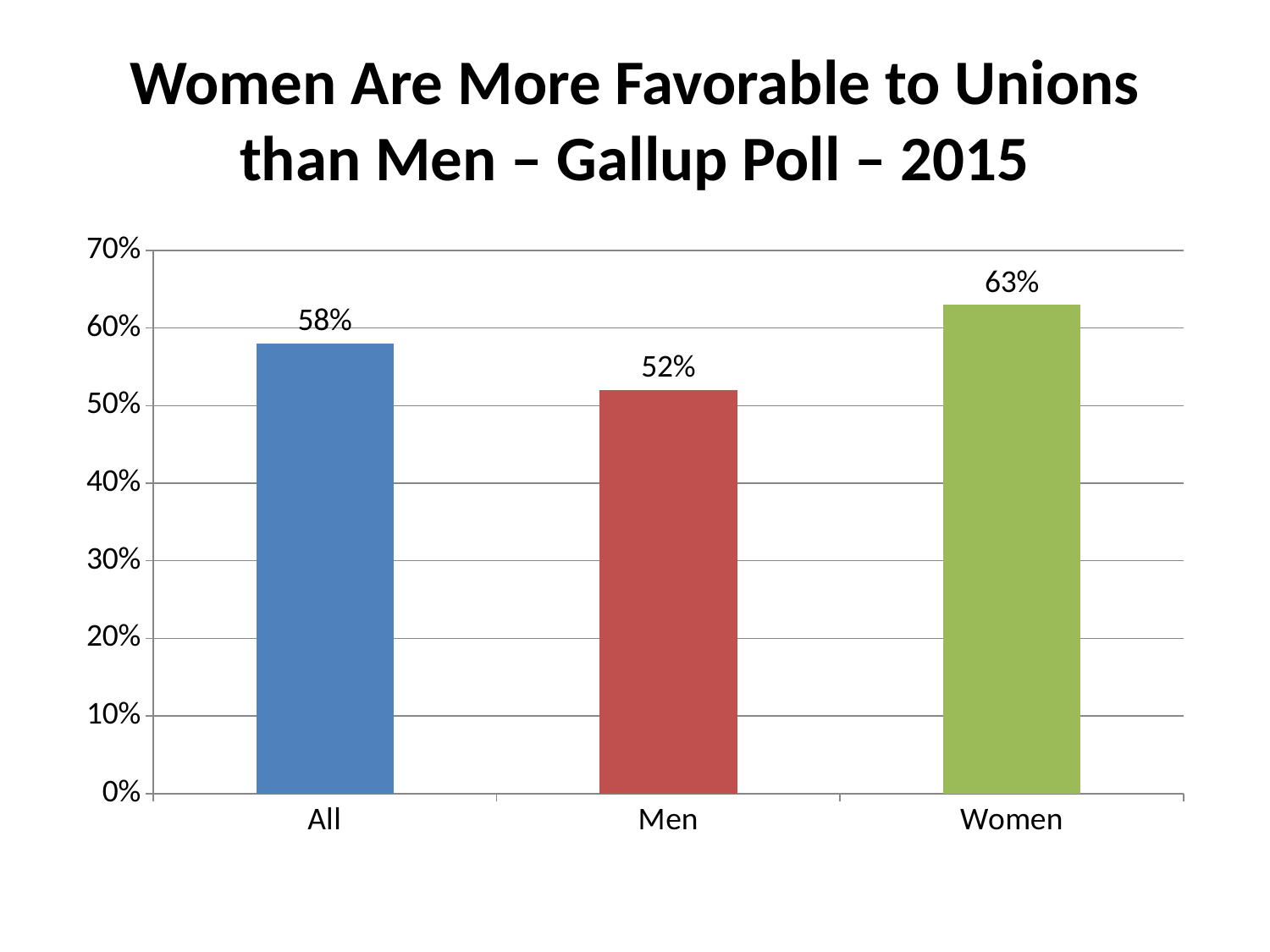
Is the value for Women greater or less than 60%? greater Which category has the highest value? Women What colour is the bar for Women? green Which is larger, the value for All or the value for Men? All What is the value for Men? 52% What is the difference between the values for All and Men? 6% What is the value for All? 58% What is the difference between the values for Women and Men? 11% What is the value for Women? 63% What kind of chart is shown on the slide? bar chart Which category has the lowest value? Men How many categories are shown on the x axis? 3